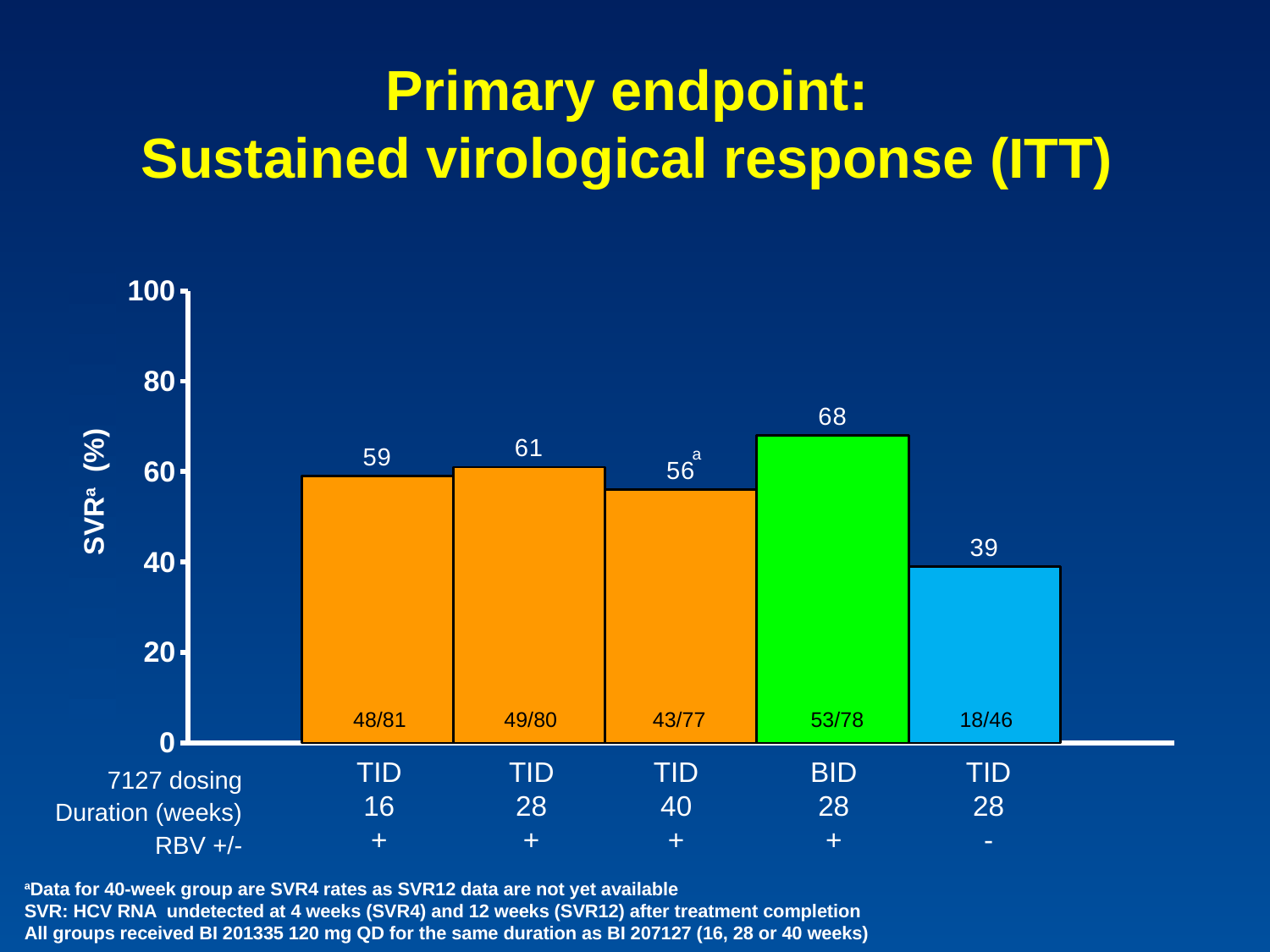
Which has a higher SVR (%): the TID 28-week group with RBV or the TID 40-week group with RBV? TID 28 weeks with RBV What is the SVR (%) for the BID 28-week group with RBV? 68 How many treatment groups are shown in the chart? 5 What is the SVR (%) for the TID 40-week group with RBV? 56 Which group has the highest SVR (%)? BID 28 weeks with RBV Which group has the lowest SVR (%)? TID 28 weeks without RBV What is the SVR (%) for the TID 16-week group with RBV? 59 What is the difference in SVR (%) between the BID 28-week group with RBV and the TID 28-week group without RBV? 29 What is the SVR (%) for the TID 28-week group without RBV? 39 What is the maximum value shown on the y-axis of the chart? 100 What is the responder fraction shown inside the bar for the BID 28-week group with RBV? 53/78 What type of chart is shown on the slide? Bar chart